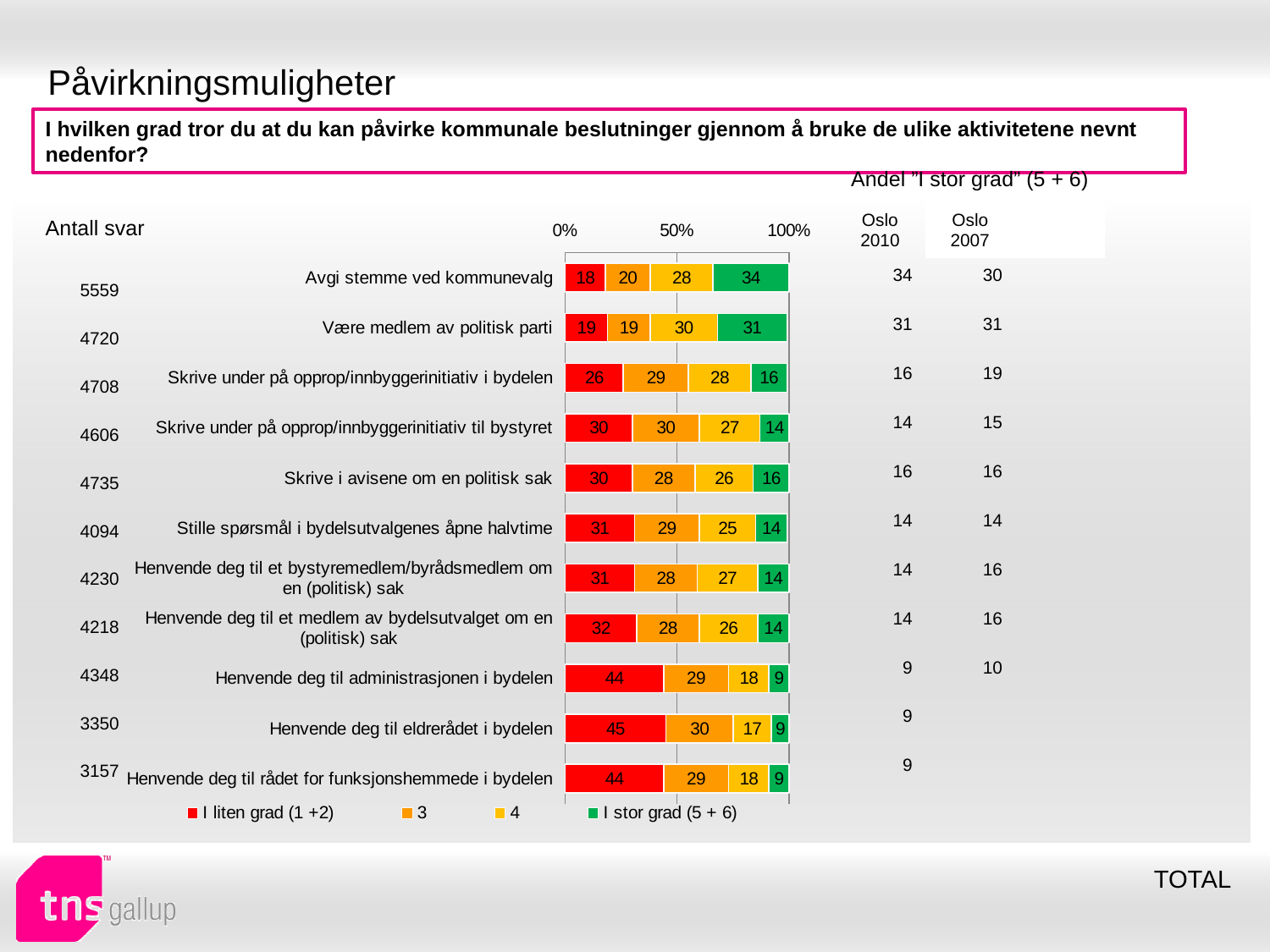
What is the total of the stacked bar for "Avgi stemme ved kommunevalg"? 100 Which colour represents "I stor grad (5 + 6)" in the chart? Green How many series does the chart legend list? 4 Which is larger: the "I stor grad (5 + 6)" value for "Være medlem av politisk parti" or for "Skrive i avisene om en politisk sak"? Være medlem av politisk parti What is the value of "I stor grad (5 + 6)" for "Avgi stemme ved kommunevalg"? 34 Which category has the lowest value for "I liten grad (1 +2)"? Avgi stemme ved kommunevalg What is the difference between the "I liten grad (1 +2)" values for "Henvende deg til administrasjonen i bydelen" and "Avgi stemme ved kommunevalg"? 26 What is the value of series "3" for "Skrive under på opprop/innbyggerinitiativ i bydelen"? 29 What kind of chart is shown on the slide? Stacked bar chart How many categories (activities) are shown in the bar chart? 11 What is the value of "I liten grad (1 +2)" for "Henvende deg til eldrerådet i bydelen"? 45 Which category has the highest value for "I stor grad (5 + 6)"? Avgi stemme ved kommunevalg